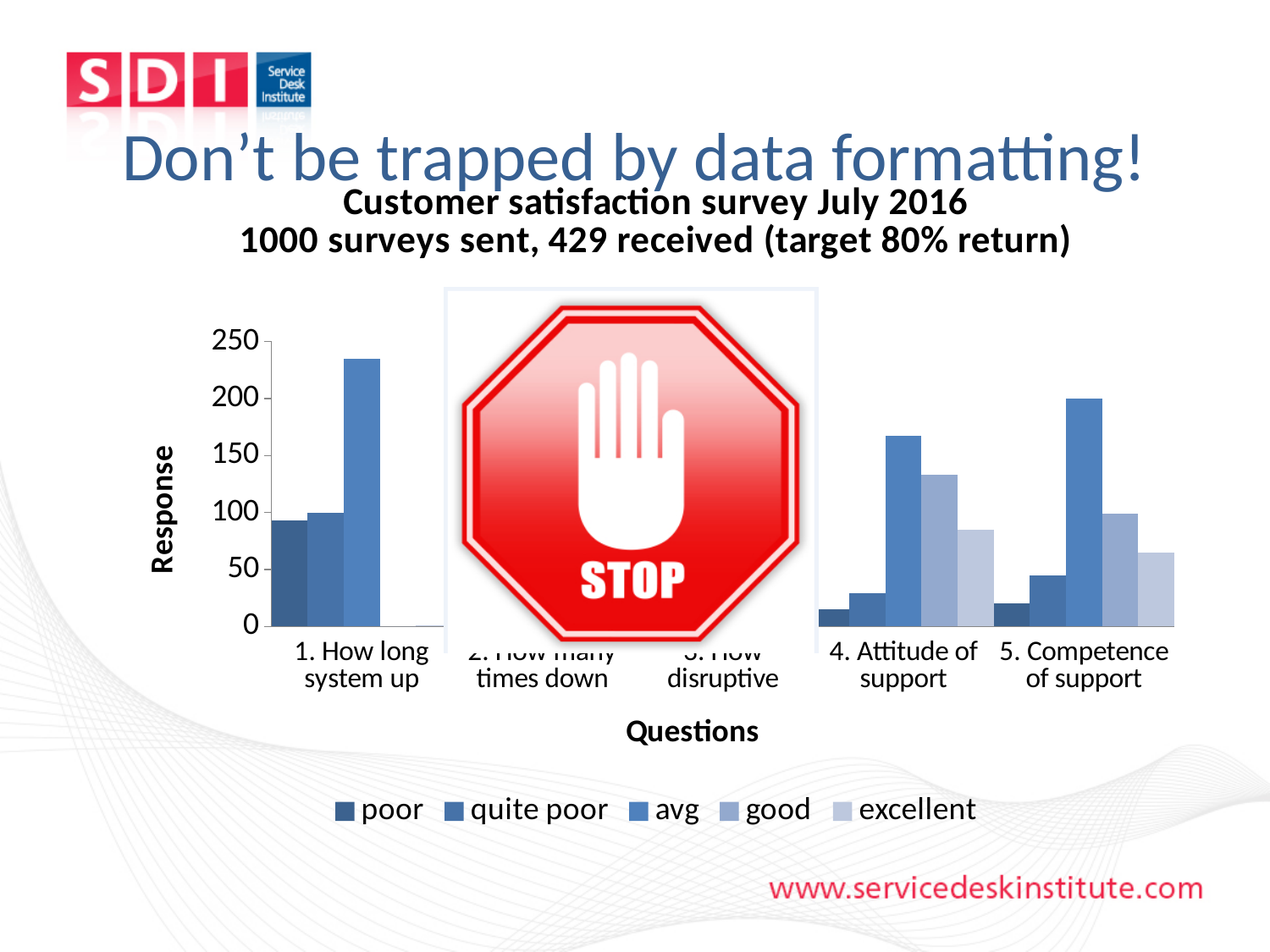
Is the 'good' value for '4. Attitude of support' greater or less than 100? greater Which series has the highest value for '5. Competence of support'? avg How many series does the legend list? 5 Is the 'avg' value for '1. How long system up' greater or less than 200? greater What is the title of the vertical axis? Response Which is larger, the 'avg' value for '5. Competence of support' or the 'avg' value for '4. Attitude of support'? 5. Competence of support Which series has the lowest value for '4. Attitude of support'? poor What are the legend entries of the chart? poor, quite poor, avg, good, excellent Is the 'excellent' value for '4. Attitude of support' greater or less than 100? less What kind of chart is shown on the slide? bar chart How many question categories are shown along the x axis? 5